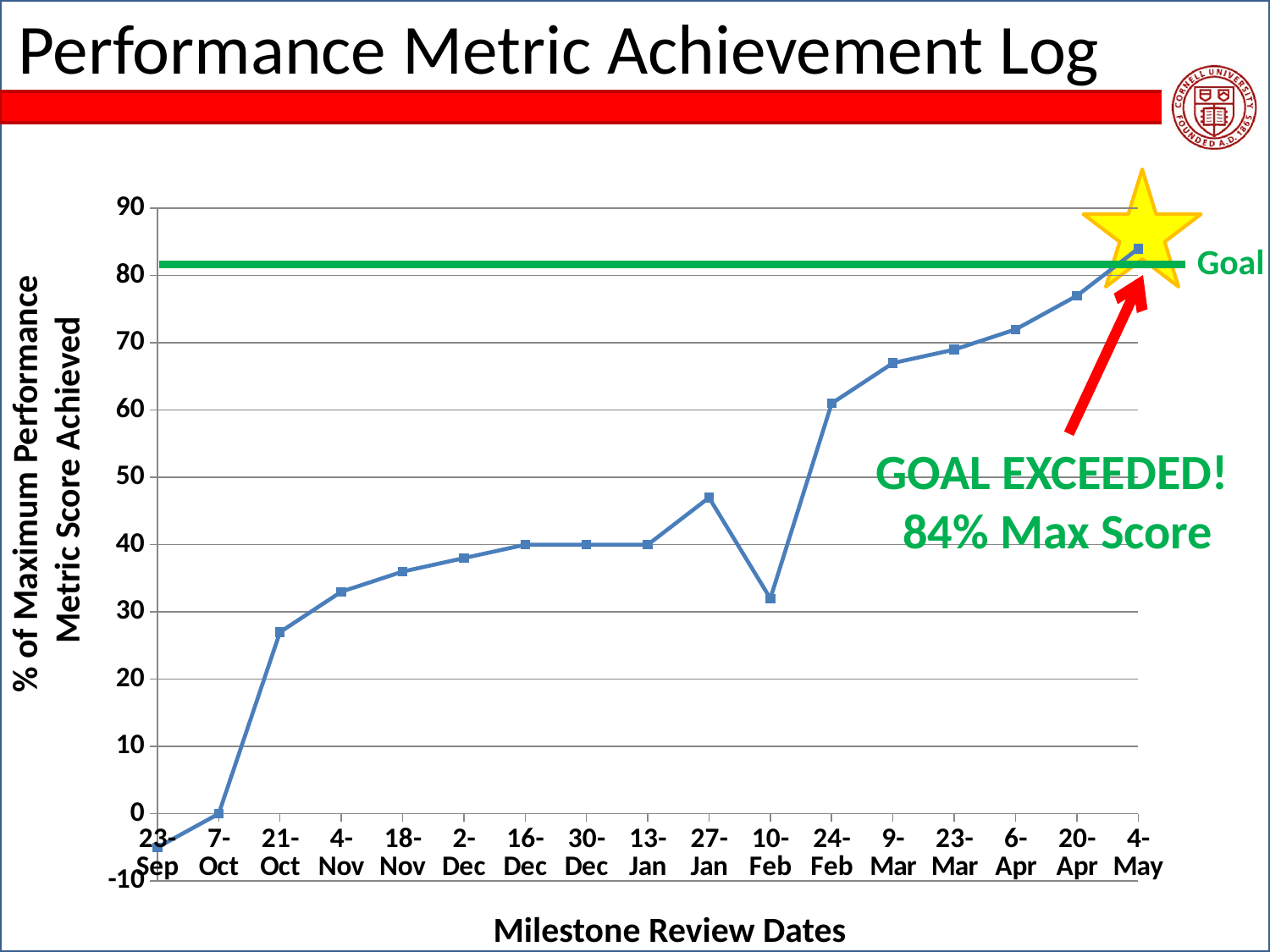
Which is larger, the value for 27-Jan or the value for 10-Feb? 27-Jan Which milestone review date has the lowest score? 23-Sep What value is plotted for 7-Oct? 0 What value is plotted for 16-Dec? 40 How many milestone review dates are plotted along the x axis? 17 Which milestone review date has the highest score? 4-May What kind of chart is shown on the slide? line chart What is the title of the x axis? Milestone Review Dates Is the value for 10-Feb greater or less than 40? less Is the value for 24-Feb greater or less than 50? greater What percentage of the maximum score was achieved on 4-May? 84% Do the plotted scores generally rise or fall from 23-Sep to 4-May? rise